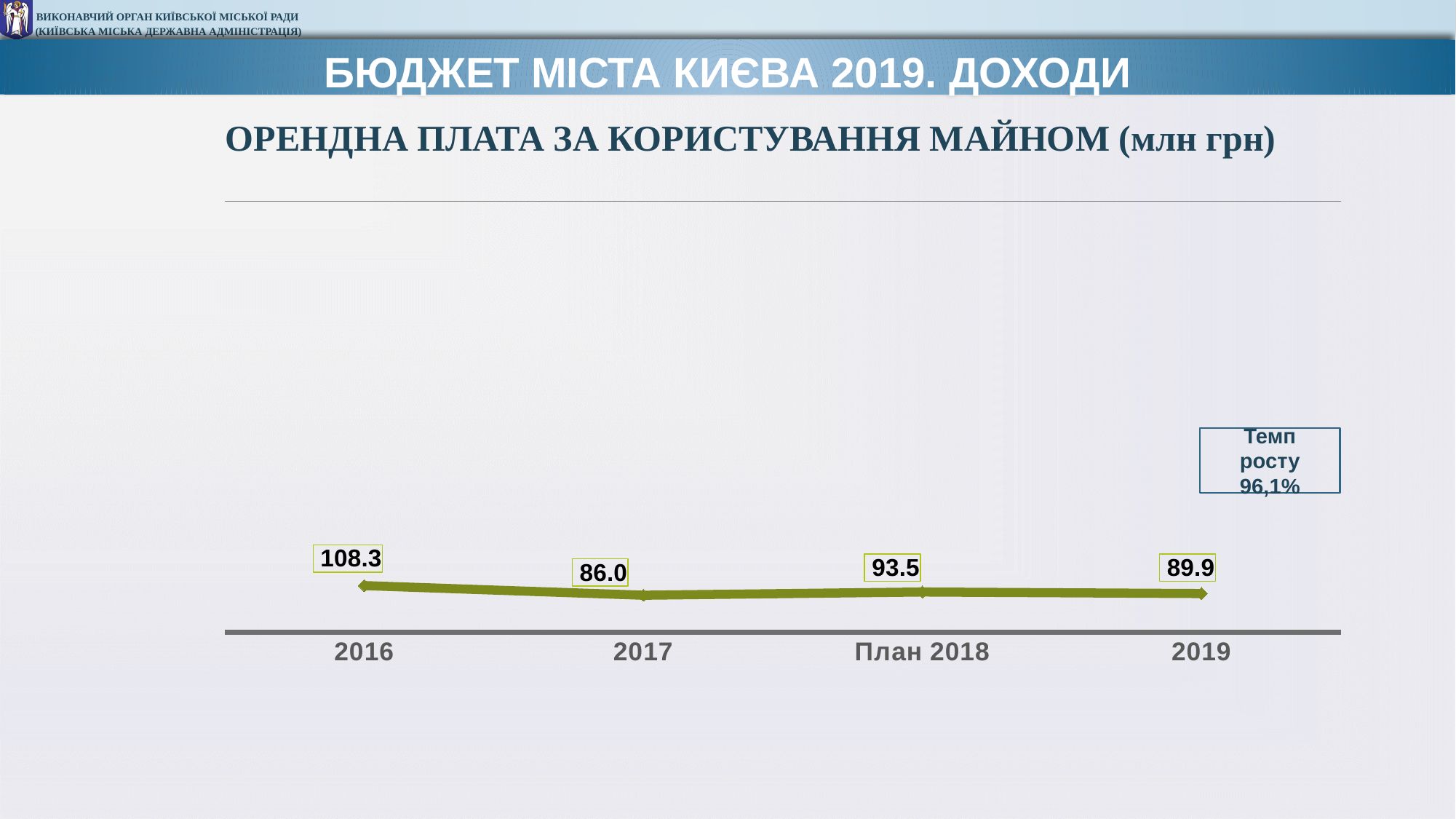
What is the value for 2019? 89.9 What is the value for 2016? 108.3 Which year has the lowest value? 2017 How many data points are plotted on the chart? 4 Which is larger, the value for План 2018 or the value for 2019? План 2018 What kind of chart is shown on the slide? Line chart What is the difference between the values for 2016 and 2017? 22.3 Which year has the highest value? 2016 What growth rate (Темп росту) is shown in the box on the chart? 96,1% What is the value for 2017? 86.0 What is the value for План 2018? 93.5 What is the difference between the values for План 2018 and 2019? 3.6